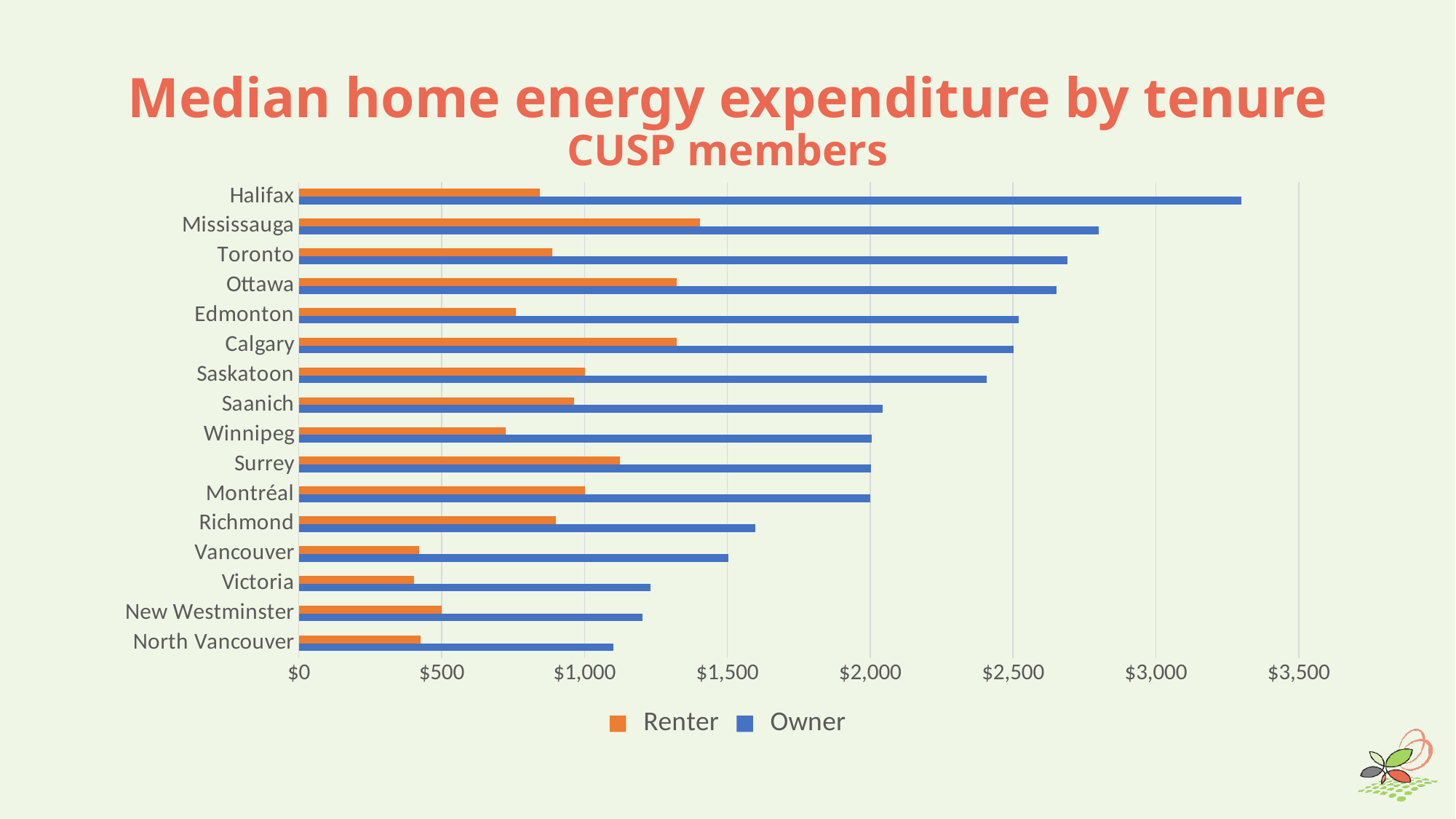
Is the Owner value for Halifax greater or less than $3,000? greater Is the Owner value for Victoria greater or less than $1,500? less How many series does the legend list? 2 Which city has the lowest Owner median home energy expenditure? North Vancouver Is the Renter value for Vancouver greater or less than $500? less Which is larger, the Renter value for Ottawa or the Renter value for Toronto? Ottawa Which series is shown in orange in the legend? Renter Which city has the highest Renter median home energy expenditure? Mississauga Which city has the highest Owner median home energy expenditure? Halifax What kind of chart is shown on the slide? bar chart How many cities are shown on the chart? 16